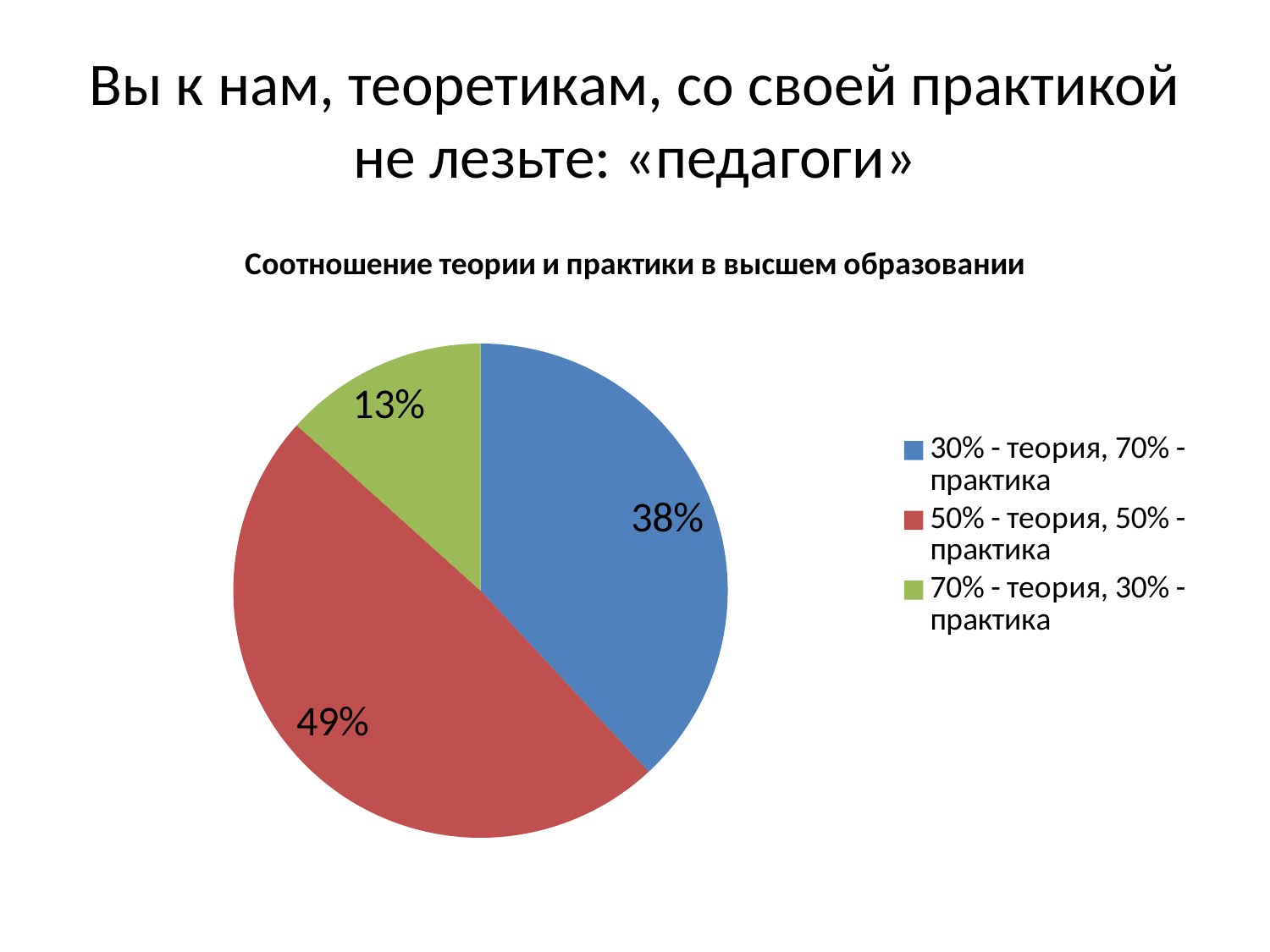
What share of the pie is labelled "50% - теория, 50% - практика"? 49% What colour is the slice for "70% - теория, 30% - практика"? green Which is larger: the share for "30% - теория, 70% - практика" or the share for "70% - теория, 30% - практика"? 30% - теория, 70% - практика What is the title of the chart? Соотношение теории и практики в высшем образовании What kind of chart is shown on the slide? pie chart What share of the pie is labelled "30% - теория, 70% - практика"? 38% What is the difference between the shares for "50% - теория, 50% - практика" and "30% - теория, 70% - практика"? 11% What share of the pie is labelled "70% - теория, 30% - практика"? 13% Which category has the largest slice of the pie? 50% - теория, 50% - практика How many slices does the pie chart have? 3 How many entries does the legend list? 3 Which category has the smallest slice of the pie? 70% - теория, 30% - практика